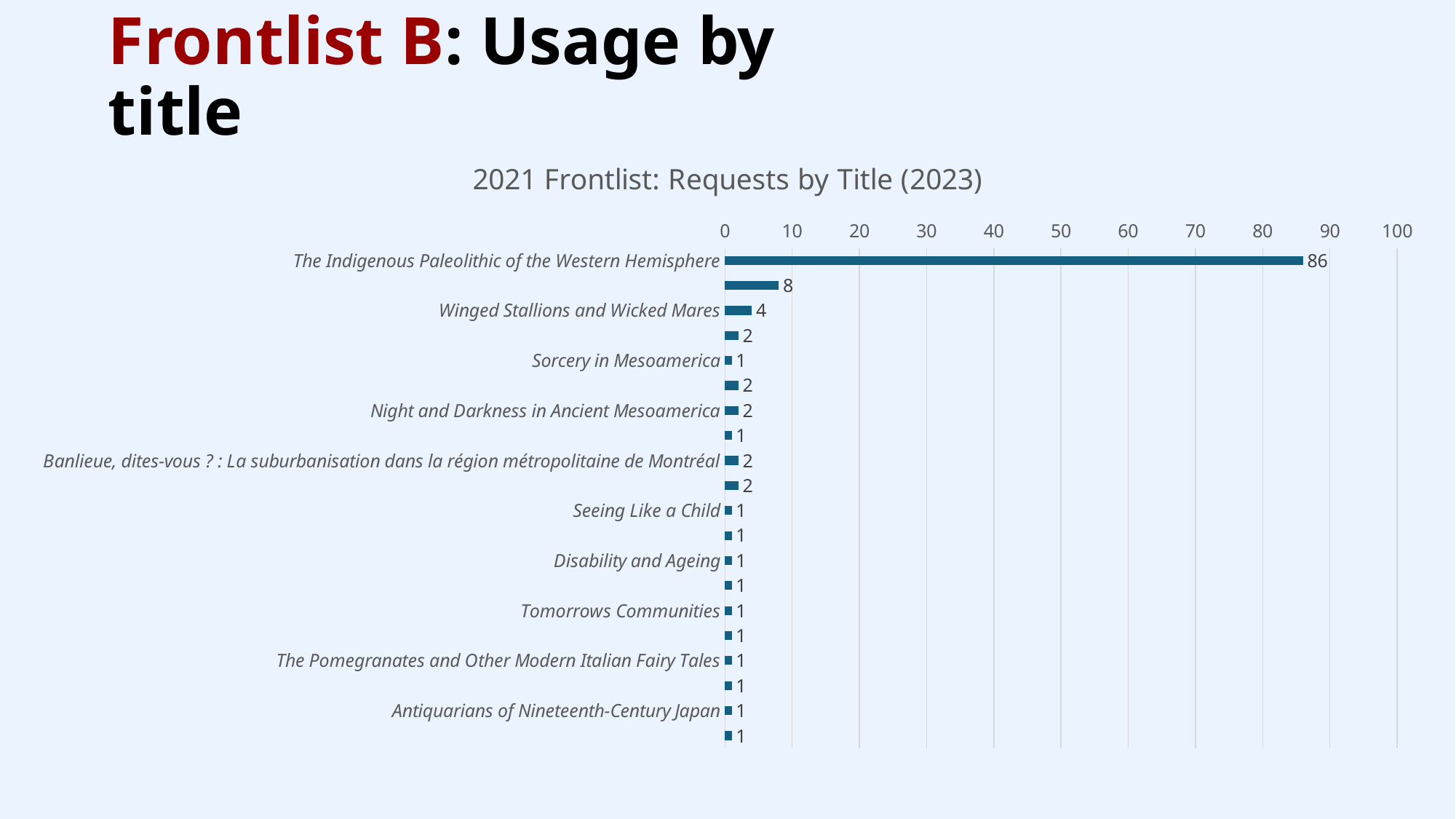
What type of chart is shown on the slide? bar chart Which title has the highest number of requests? The Indigenous Paleolithic of the Western Hemisphere How many requests does Winged Stallions and Wicked Mares have? 4 How many bars are plotted in the chart? 20 How many requests does The Indigenous Paleolithic of the Western Hemisphere have? 86 Is the value for The Indigenous Paleolithic of the Western Hemisphere greater or less than 80? greater How many requests does Sorcery in Mesoamerica have? 1 How many requests does Night and Darkness in Ancient Mesoamerica have? 2 What is the difference in requests between The Indigenous Paleolithic of the Western Hemisphere and Winged Stallions and Wicked Mares? 82 What is the chart's title? 2021 Frontlist: Requests by Title (2023) What is the highest value shown on the horizontal axis? 100 Which has more requests, Winged Stallions and Wicked Mares or Night and Darkness in Ancient Mesoamerica? Winged Stallions and Wicked Mares